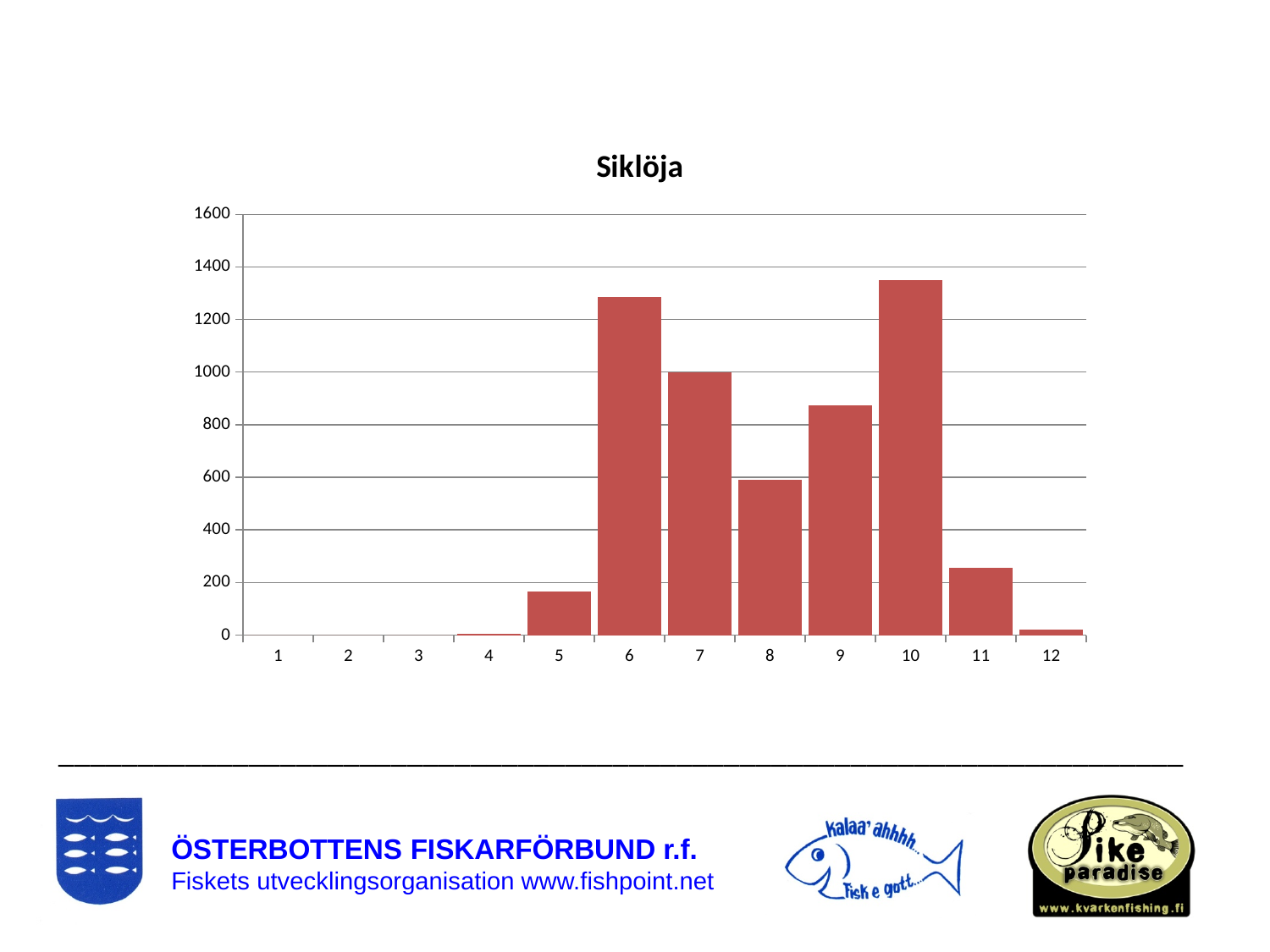
What is the title of the chart? Siklöja Is the value for category 6 greater or less than 1200? greater Which has the larger value, category 8 or category 9? 9 Do the values rise or fall from category 6 to category 8? fall How many categories are shown on the x axis of the chart? 12 Is the value for category 8 greater or less than 400? greater What kind of chart is shown on the slide? bar chart Which category has the highest value in the chart? 10 Is the value for category 11 greater or less than 200? greater Which has the larger value, category 6 or category 7? 6